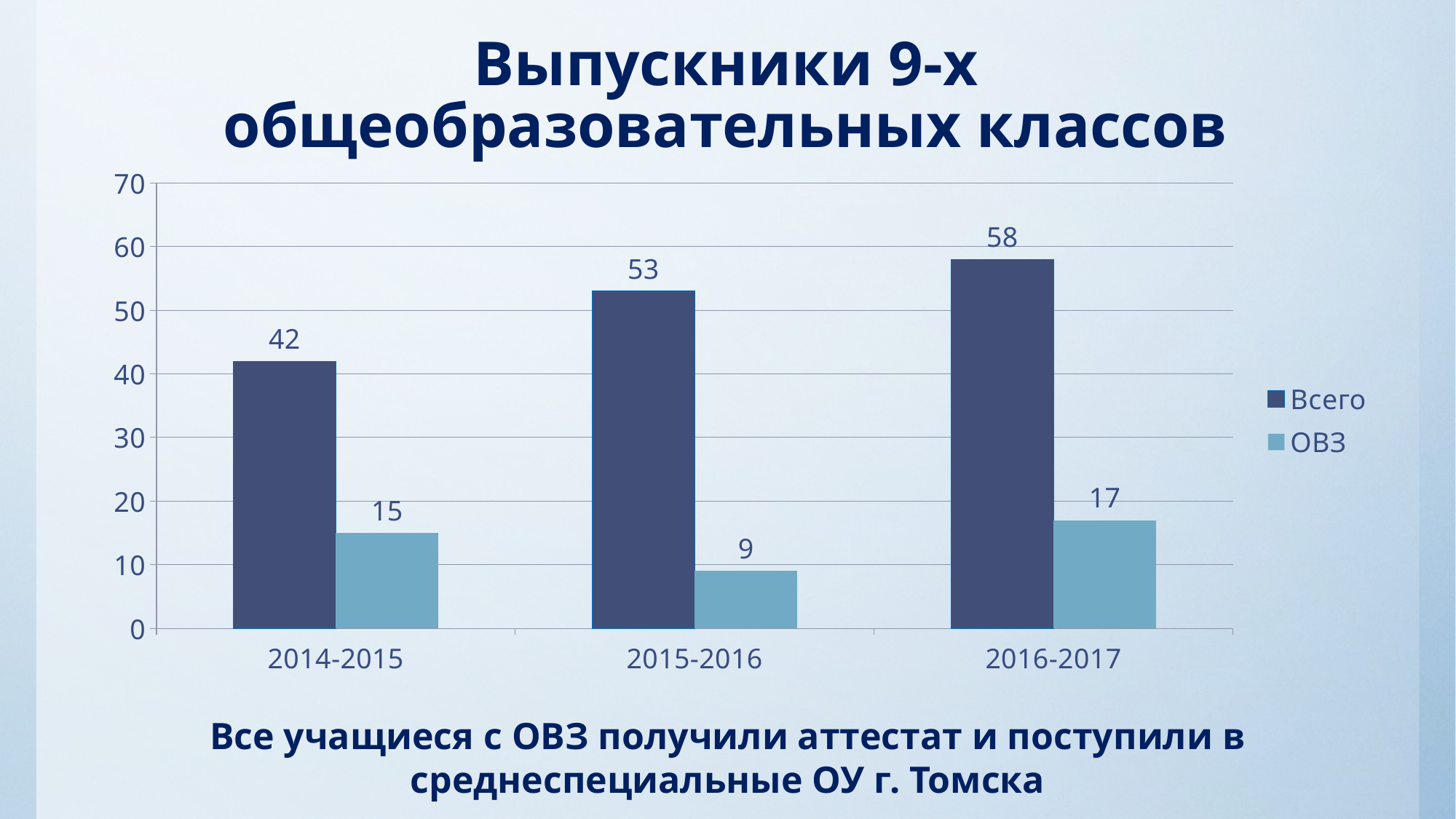
What is the value of Всего for 2014-2015? 42 How many series does the legend list? 2 How many year categories are shown on the x axis? 3 Does the Всего series rise or fall from 2014-2015 to 2016-2017? rise What is the difference between Всего and ОВЗ in 2016-2017? 41 What kind of chart is shown on the slide? bar chart What is the value of ОВЗ for 2015-2016? 9 What is the value of Всего for 2016-2017? 58 Is the value of Всего for 2015-2016 greater or less than 50? greater Which year has the highest value for Всего? 2016-2017 Which is larger: ОВЗ in 2014-2015 or ОВЗ in 2016-2017? ОВЗ in 2016-2017 Which year has the lowest value for ОВЗ? 2015-2016